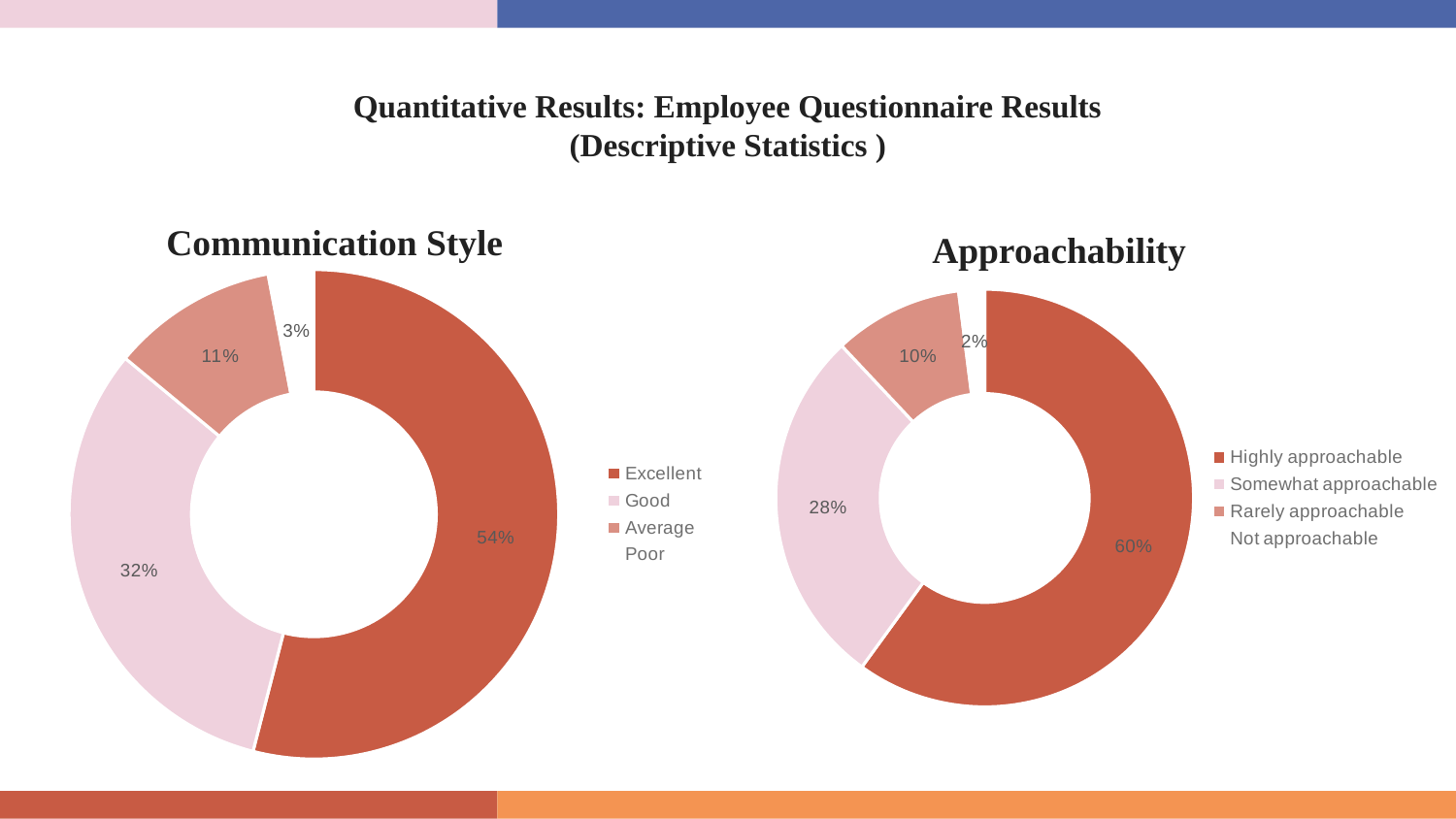
In the Communication Style chart, what percentage is shown for Average? 11% In the Communication Style chart, which category has the largest share? Excellent In the Communication Style chart, what percentage is shown for Poor? 3% In the Approachability chart, which category has the smallest share? Not approachable In the Communication Style chart, what is the difference between the Excellent and Good percentages? 22% In the Communication Style chart, what percentage of respondents rated communication style as Excellent? 54% How many categories does the legend of the Approachability chart list? 4 In the Approachability chart, which is larger: Somewhat approachable or Rarely approachable? Somewhat approachable In the Communication Style chart, what percentage is shown for Good? 32% In the Approachability chart, what percentage is shown for Not approachable? 2% In the Approachability chart, what percentage is shown for Somewhat approachable? 28% In the Approachability chart, what percentage of respondents chose Highly approachable? 60%